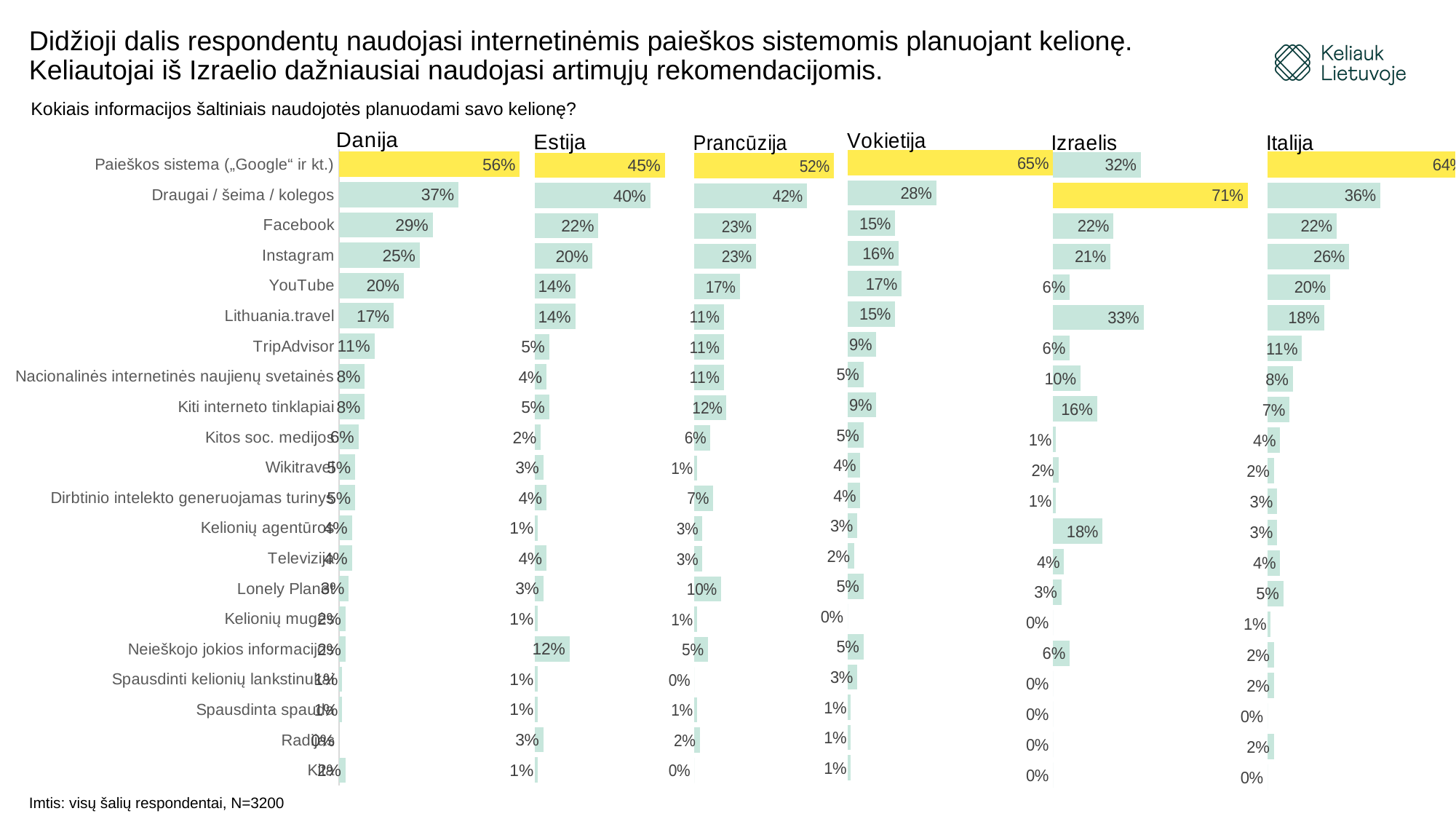
In the Vokietija chart, which information source has the highest value? Paieškos sistema („Google“ ir kt.) In the Prancūzija chart, what is the value for Lonely Planet? 10% How many country charts are shown on the slide? 6 In the Izraelis chart, how much higher is Draugai / šeima / kolegos than Paieškos sistema („Google“ ir kt.)? 39 percentage points What type of chart is used for each country on the slide? Bar chart In the Italija chart, what is the difference between Paieškos sistema („Google“ ir kt.) and Draugai / šeima / kolegos? 28 percentage points In the Izraelis chart, which information source has the highest value? Draugai / šeima / kolegos In the Izraelis chart, what is the value for Lithuania.travel? 33% How many information source categories are listed in each country chart? 21 In the Danija chart, what percentage of respondents used Facebook? 29% In the Estija chart, what is the value for Neieškojo jokios informacijos? 12% In the Estija chart, which is larger: Facebook or Instagram? Facebook